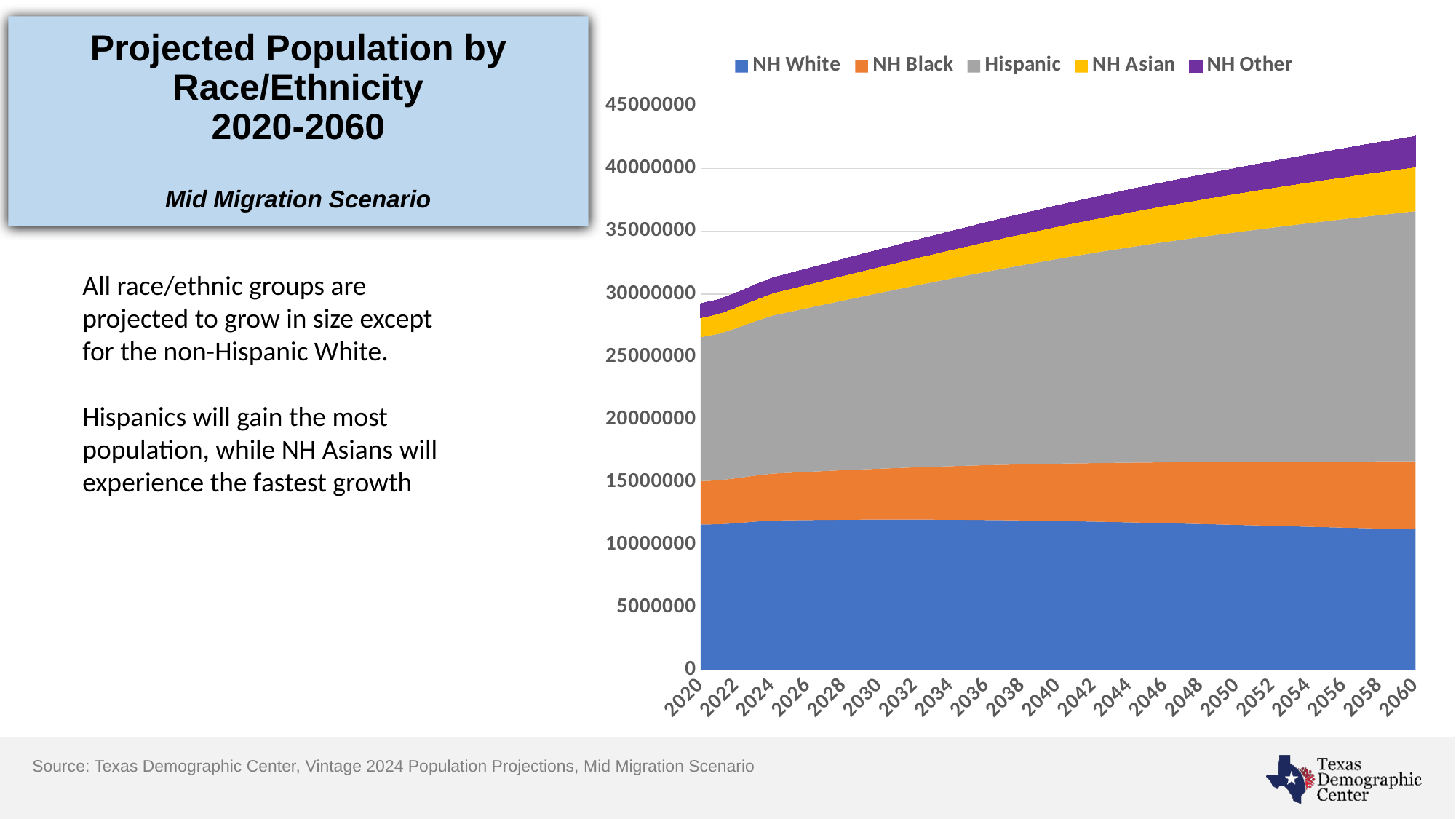
Does the total projected population rise or fall from 2020 to 2060? Rises Is the total projected population in 2060 greater or less than 40000000? greater Is the NH White projected population in 2020 greater or less than 10000000? greater Which colour represents the Hispanic series in the chart? Gray How many series does the chart's legend list? 5 Is the total projected population in 2050 greater or less than 35000000? greater In 2060, which is larger: the Hispanic projected population or the NH White projected population? Hispanic How many year labels are shown along the x axis of the chart? 21 What kind of chart is shown on the slide? Stacked area chart Which race/ethnic group has the largest projected population in 2060? Hispanic Which race/ethnic group has the smallest projected population in 2020? NH Other